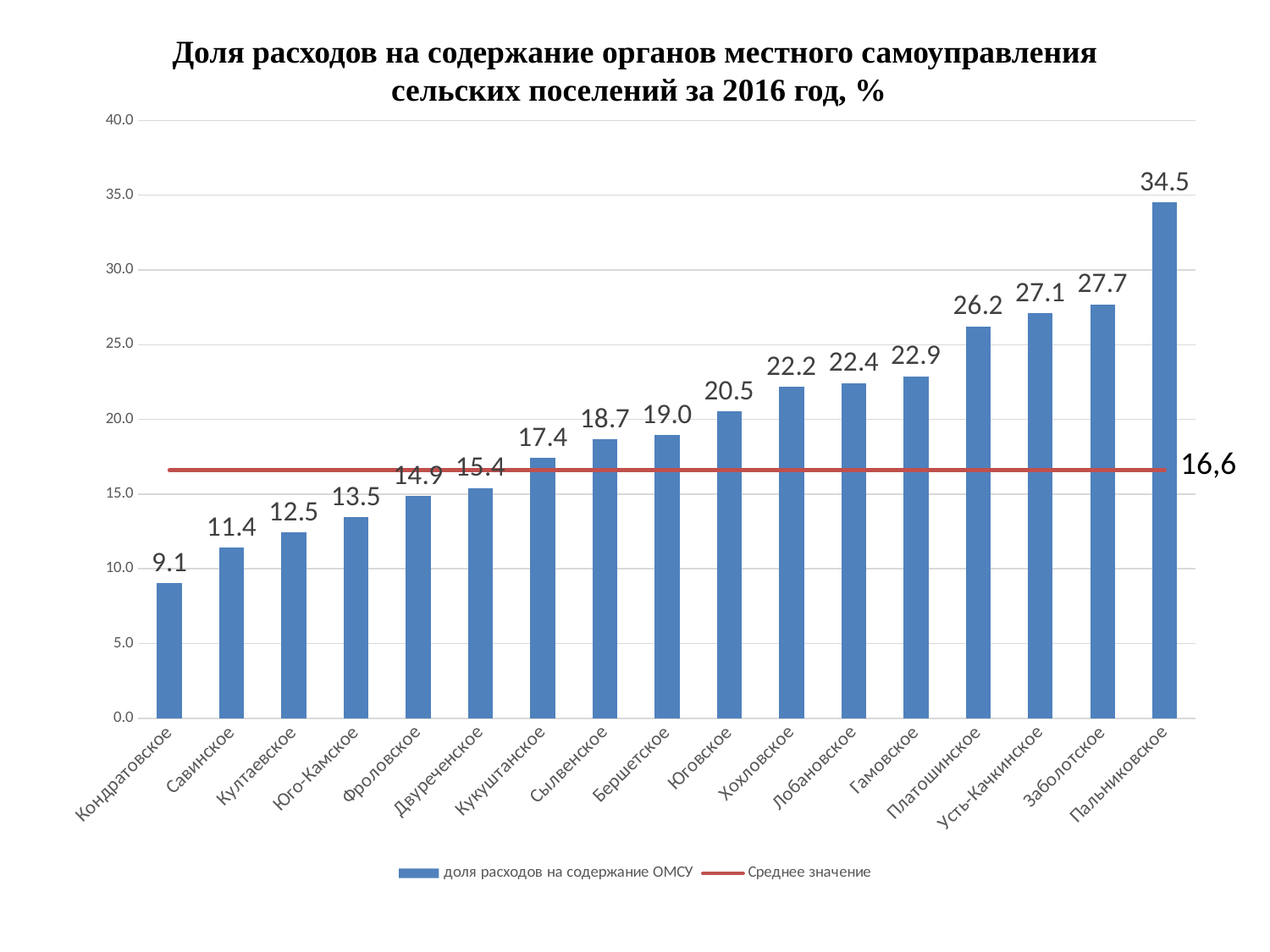
What is the value for Кондратовское? 9.1 What is the difference between the values for Пальниковское and Заболотское? 6.8 Which is larger, the value for Сылвенское or the value for Юговское? Юговское How many entries does the legend list? 2 What is the value for Гамовское? 22.9 Is the value for Платошинское greater or less than 25.0? greater What is the value of the average line (Среднее значение)? 16,6 Which settlement has the highest share? Пальниковское What is the value for Усть-Качкинское? 27.1 What kind of chart is this? combination bar and line chart Which settlement has the lowest share? Кондратовское How many settlements are shown on the x axis? 17